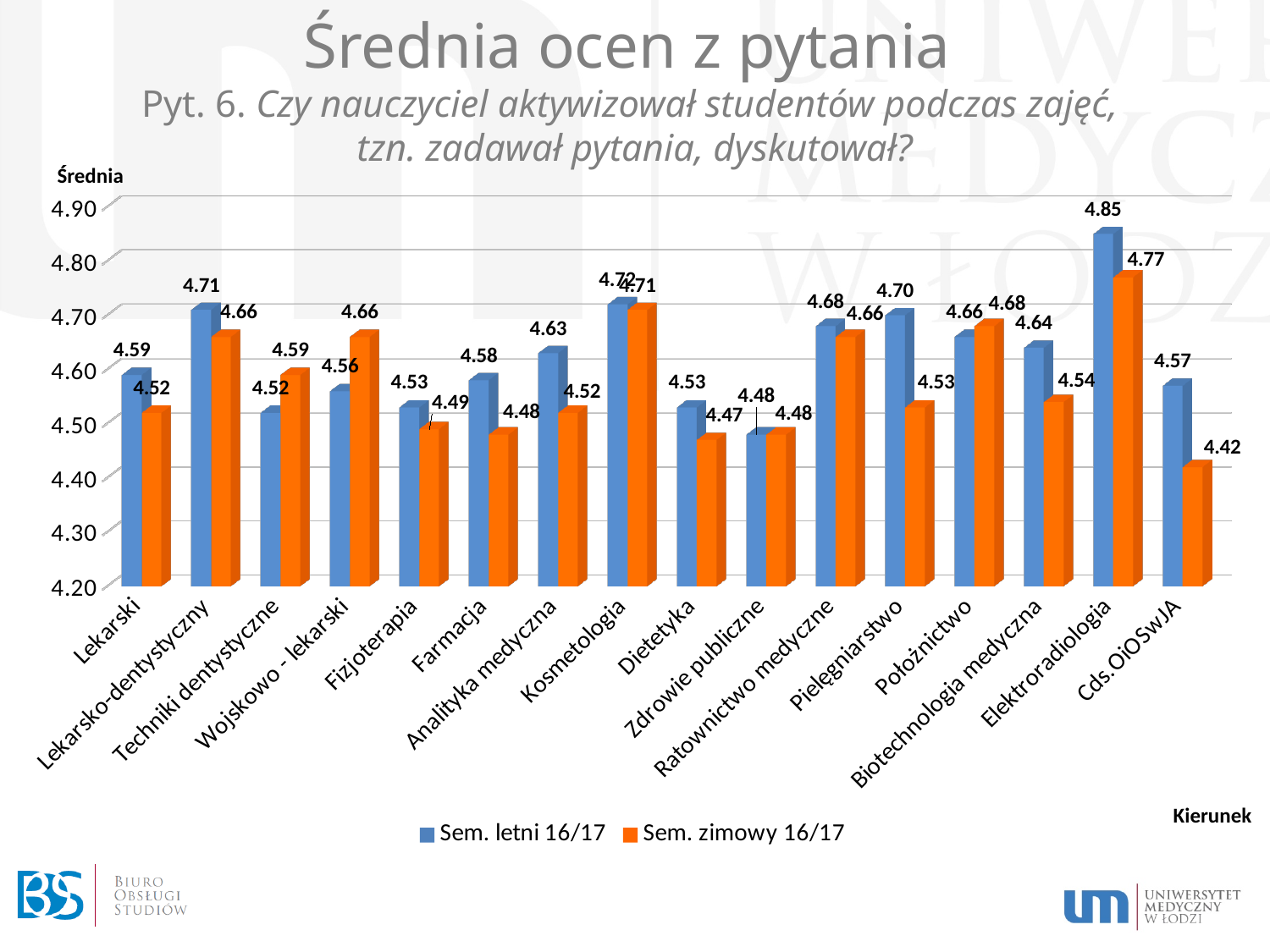
Is the Sem. letni 16/17 value for Kosmetologia greater or less than 4.70? greater What is the difference between the Sem. letni 16/17 and Sem. zimowy 16/17 values for Cds.OiOSwJA? 0.15 What is the value for Elektroradiologia in the Sem. letni 16/17 series? 4.85 How many categories (kierunki) are shown on the x axis? 16 Which category has the highest value in the Sem. letni 16/17 series? Elektroradiologia Which category has the lowest value in the Sem. zimowy 16/17 series? Cds.OiOSwJA What is the difference between the Sem. letni 16/17 and Sem. zimowy 16/17 values for Pielęgniarstwo? 0.17 For Wojskowo - lekarski, which series has the larger value: Sem. letni 16/17 or Sem. zimowy 16/17? Sem. zimowy 16/17 What kind of chart is shown on the slide? Bar chart What is the value for Pielęgniarstwo in the Sem. zimowy 16/17 series? 4.53 How many series does the legend list? 2 What is the value for Farmacja in the Sem. zimowy 16/17 series? 4.48